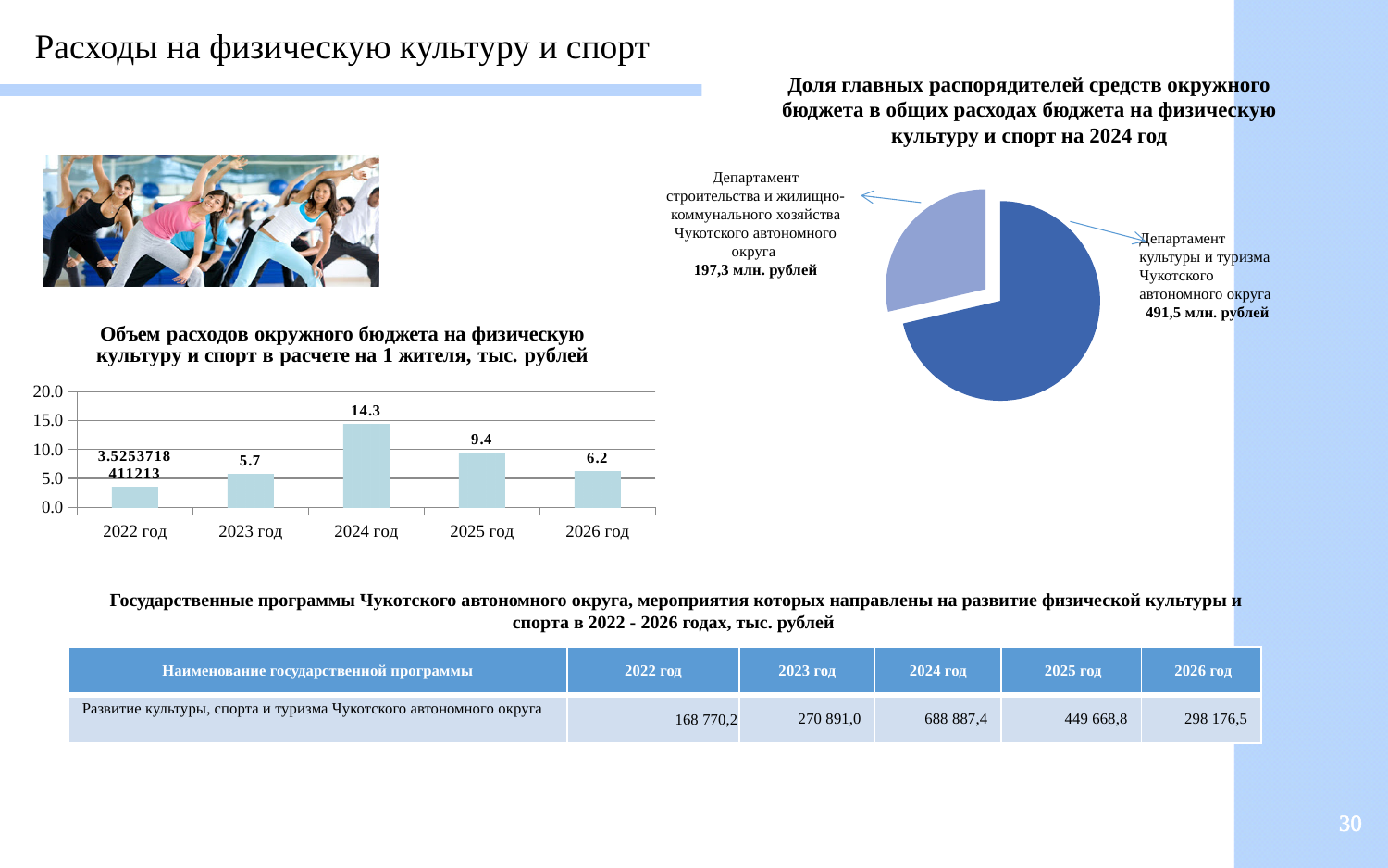
In the pie chart 'Доля главных распорядителей средств окружного бюджета...на 2024 год', what is the value for Департамент строительства и жилищно-коммунального хозяйства Чукотского автономного округа? 197,3 млн. рублей What type of chart is 'Объем расходов окружного бюджета на физическую культуру и спорт в расчете на 1 жителя'? Bar chart How many years are shown in the bar chart 'Объем расходов окружного бюджета на физическую культуру и спорт в расчете на 1 жителя'? 5 In the bar chart 'Объем расходов окружного бюджета на физическую культуру и спорт в расчете на 1 жителя', which year has the lowest value? 2022 год In the bar chart 'Объем расходов окружного бюджета на физическую культуру и спорт в расчете на 1 жителя', what is the value for 2024 год? 14.3 In the bar chart 'Объем расходов окружного бюджета на физическую культуру и спорт в расчете на 1 жителя', which year has the highest value? 2024 год In the bar chart 'Объем расходов окружного бюджета на физическую культуру и спорт в расчете на 1 жителя', which is larger, the value for 2023 год or 2026 год? 2026 год In the pie chart 'Доля главных распорядителей средств окружного бюджета...на 2024 год', what is the difference between the two departments' values? 294,2 млн. рублей In the bar chart 'Объем расходов окружного бюджета на физическую культуру и спорт в расчете на 1 жителя', what is the difference between the values for 2024 год and 2025 год? 4.9 In the bar chart 'Объем расходов окружного бюджета на физическую культуру и спорт в расчете на 1 жителя', is the value for 2022 год greater or less than 5.0? less In the pie chart 'Доля главных распорядителей средств окружного бюджета...на 2024 год', what is the value for Департамент культуры и туризма Чукотского автономного округа? 491,5 млн. рублей In the bar chart 'Объем расходов окружного бюджета на физическую культуру и спорт в расчете на 1 жителя', what is the value for 2025 год? 9.4